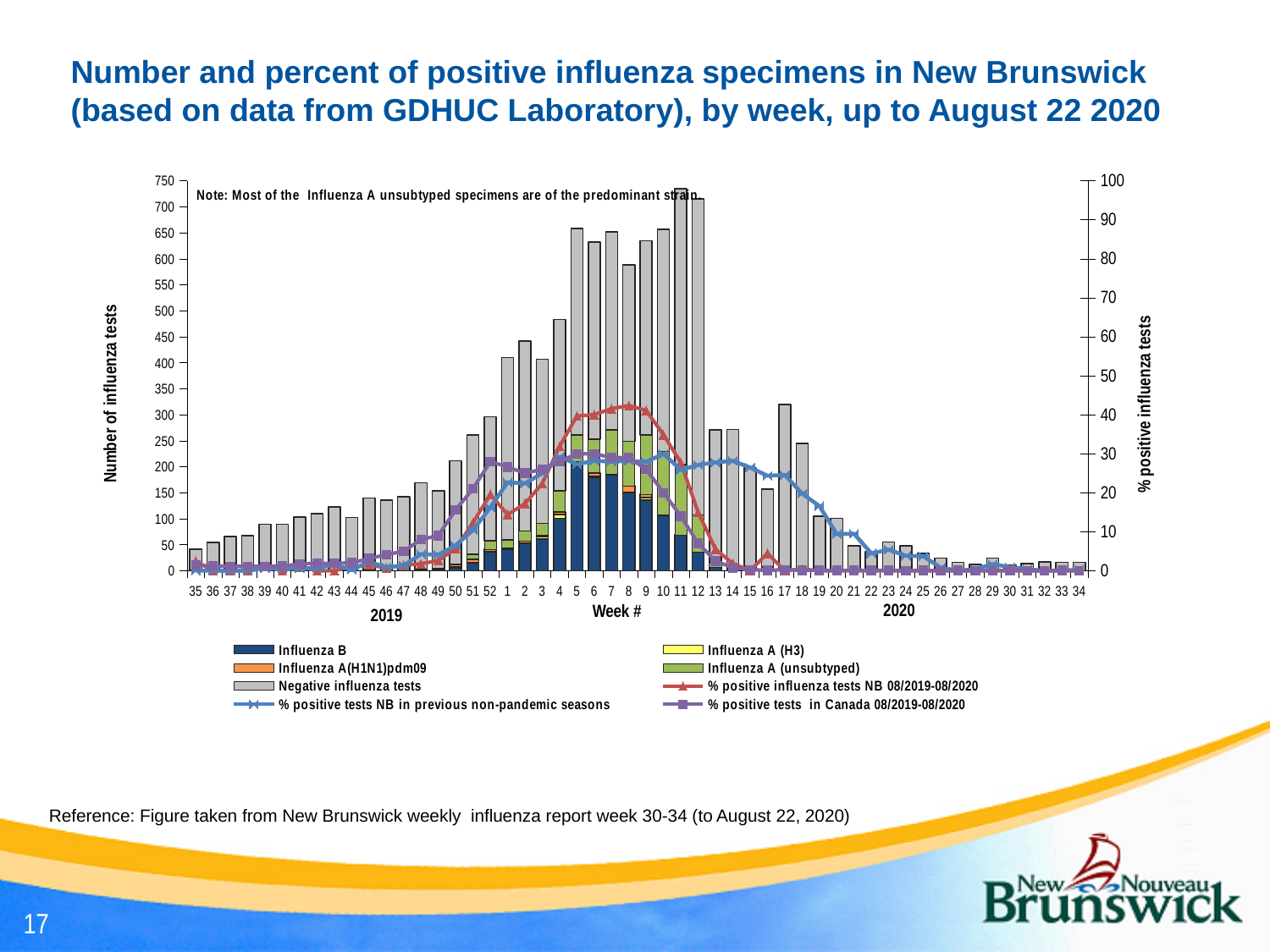
Is the % positive influenza tests NB 08/2019-08/2020 value at week 8 greater or less than 30? greater Which week has the tallest total bar? Week 11 How many entries does the legend list? 8 What is the maximum value shown on the right vertical axis? 100 What is the title of the left vertical axis? Number of influenza tests Is the total bar for week 17 greater or less than 250? greater Is the total bar for week 35 greater or less than 100? less What kind of chart is shown on the slide? A combined stacked bar and line chart How many weeks are shown along the x axis? 52 Which week has the taller total bar, week 5 or week 17? Week 5 Does the % positive influenza tests NB 08/2019-08/2020 line rise or fall from week 8 to week 14? Fall